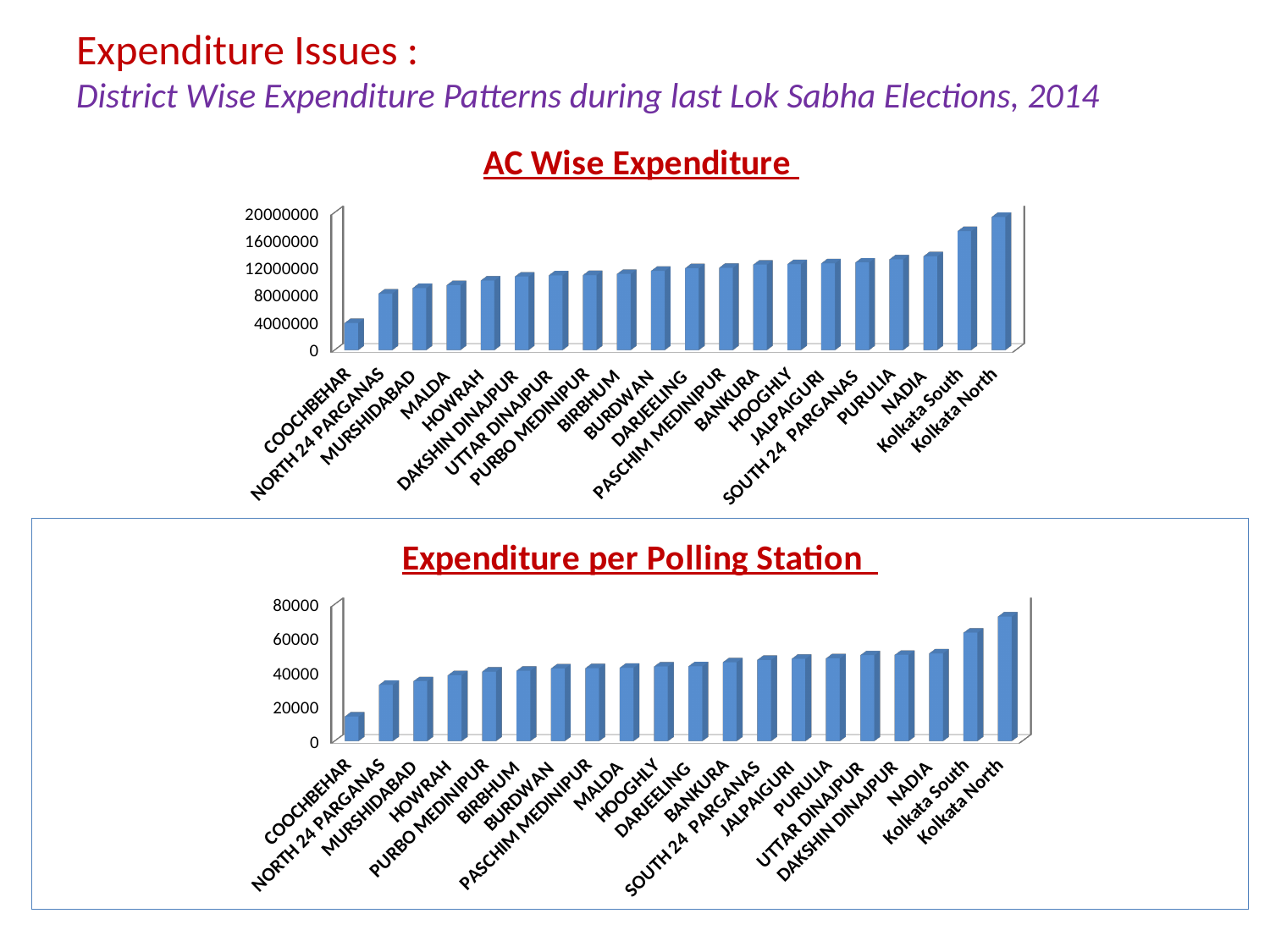
In the Expenditure per Polling Station chart, is the value for COOCHBEHAR greater or less than 20000? less What kind of chart is the AC Wise Expenditure chart? Bar chart In the AC Wise Expenditure chart, is the value for MALDA greater or less than 12000000? less In the AC Wise Expenditure chart, is the value for Kolkata North greater or less than 16000000? greater In the Expenditure per Polling Station chart, which district has the highest value? Kolkata North In the AC Wise Expenditure chart, which is larger, the value for NADIA or the value for MALDA? NADIA In the Expenditure per Polling Station chart, which district has the lowest value? COOCHBEHAR In the AC Wise Expenditure chart, which district has the highest expenditure? Kolkata North How many districts are shown in the Expenditure per Polling Station chart? 20 In the Expenditure per Polling Station chart, do the values rise or fall from left to right along the x axis? Rise In the AC Wise Expenditure chart, which district has the lowest expenditure? COOCHBEHAR